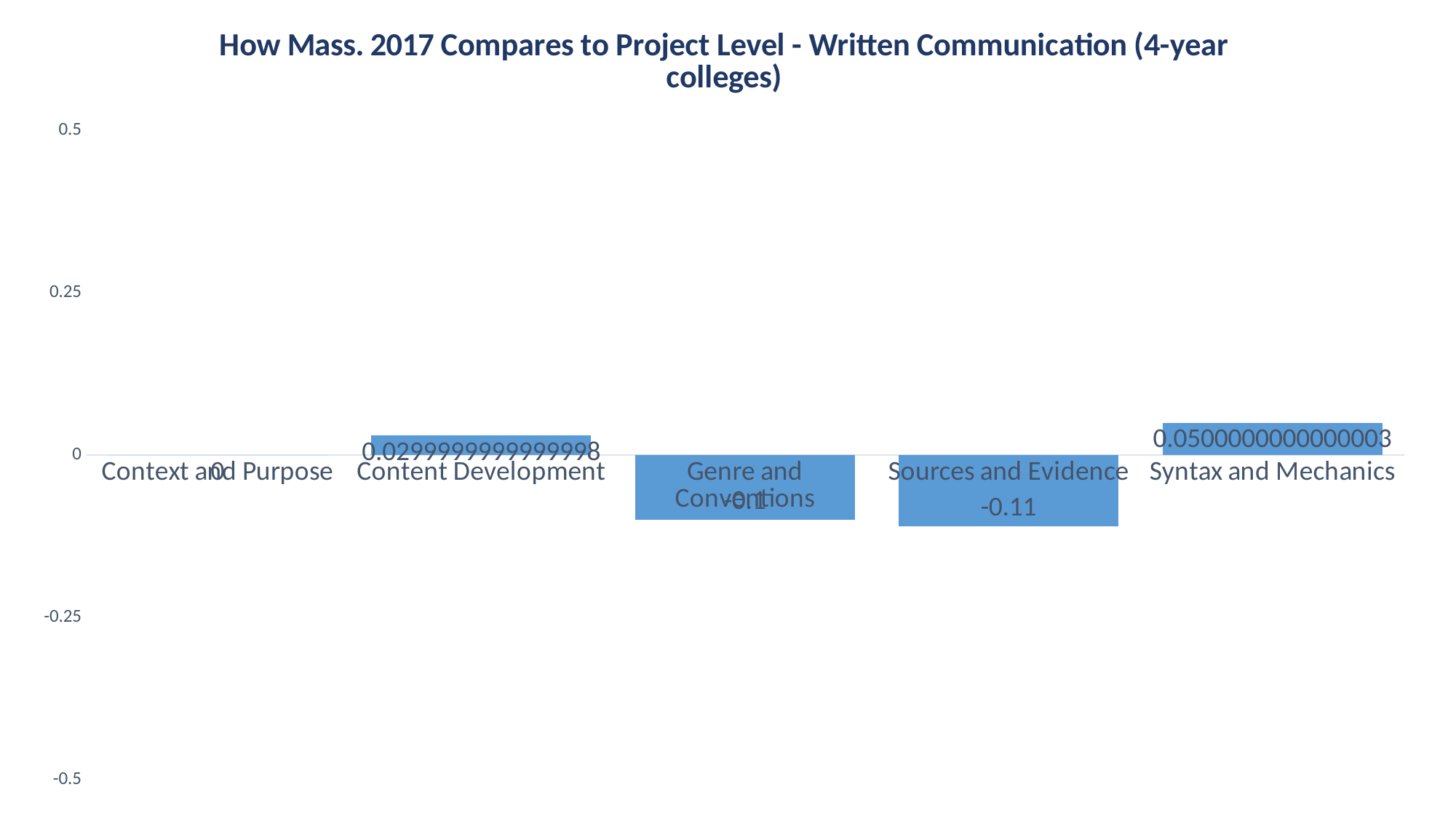
What is the value for Sources and Evidence? -0.11 What is the value for Syntax and Mechanics? 0.050000000000000003 How many categories are shown on the x axis? 5 What is the value for Context and Purpose? 0 Which category has the lowest value? Sources and Evidence Which is larger, the value for Syntax and Mechanics or the value for Content Development? Syntax and Mechanics Is the value for Sources and Evidence greater or less than -0.25? greater What is the difference between the values for Genre and Conventions and Sources and Evidence? 0.01 What is the value for Content Development? 0.029999999999999998 What kind of chart is this? bar chart What is the value for Genre and Conventions? -0.1 Which category has the highest value? Syntax and Mechanics